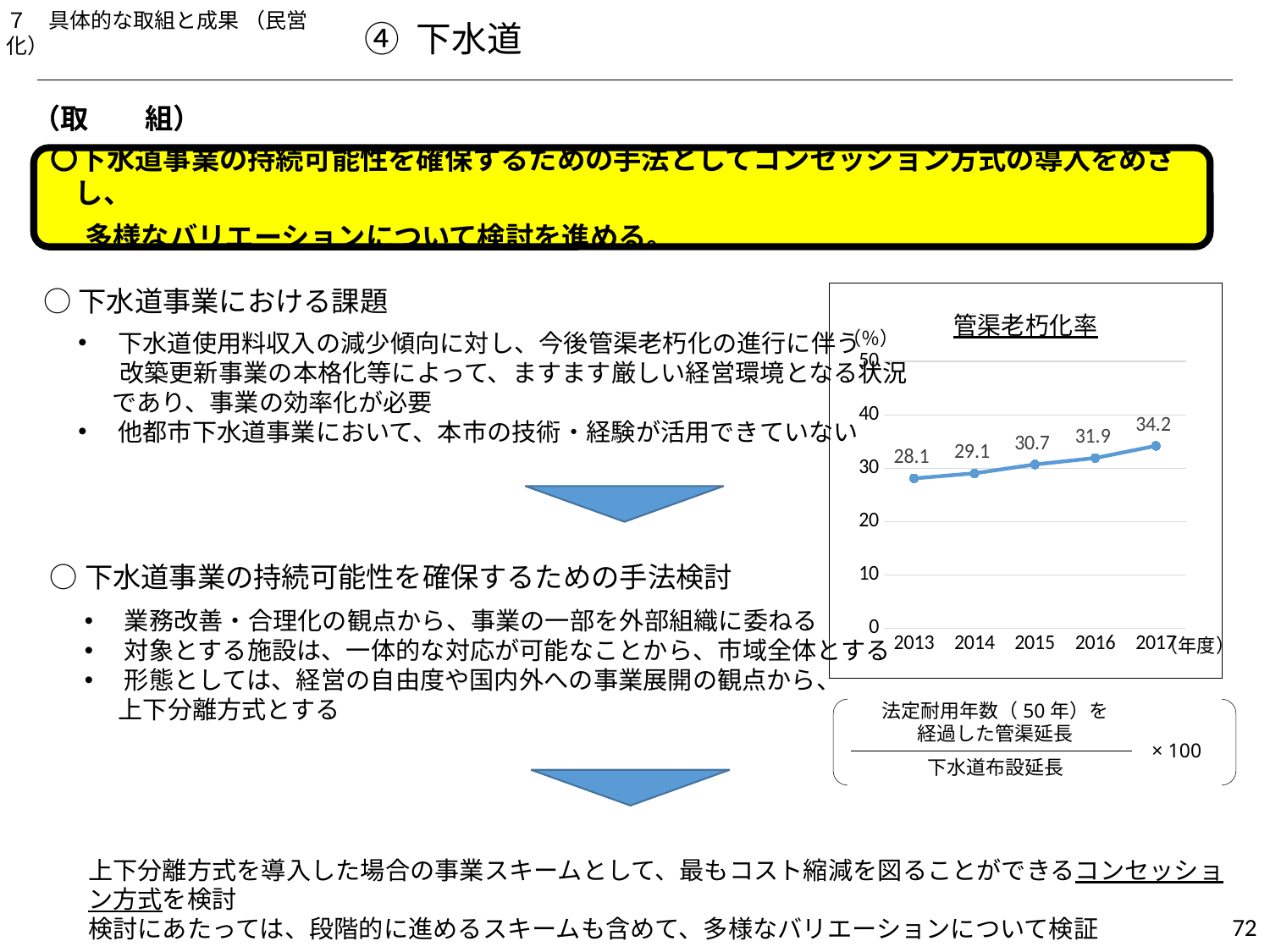
What is the difference between the 2016 and 2015 values in the 管渠老朽化率 chart? 1.2 What is the difference between the 2017 and 2013 values in the 管渠老朽化率 chart? 6.1 What is the value for 2015 in the 管渠老朽化率 chart? 30.7 How many years are plotted in the 管渠老朽化率 chart? 5 What kind of chart is the 管渠老朽化率 chart? line chart In the 管渠老朽化率 chart, is the value for 2016 larger or smaller than the value for 2014? larger What is the value for 2017 in the 管渠老朽化率 chart? 34.2 Which year has the lowest value in the 管渠老朽化率 chart? 2013 What is the value for 2013 in the 管渠老朽化率 chart? 28.1 Is the value for 2017 in the 管渠老朽化率 chart greater or less than 40? less Which year has the highest value in the 管渠老朽化率 chart? 2017 Do the values in the 管渠老朽化率 chart rise or fall from 2013 to 2017? rise